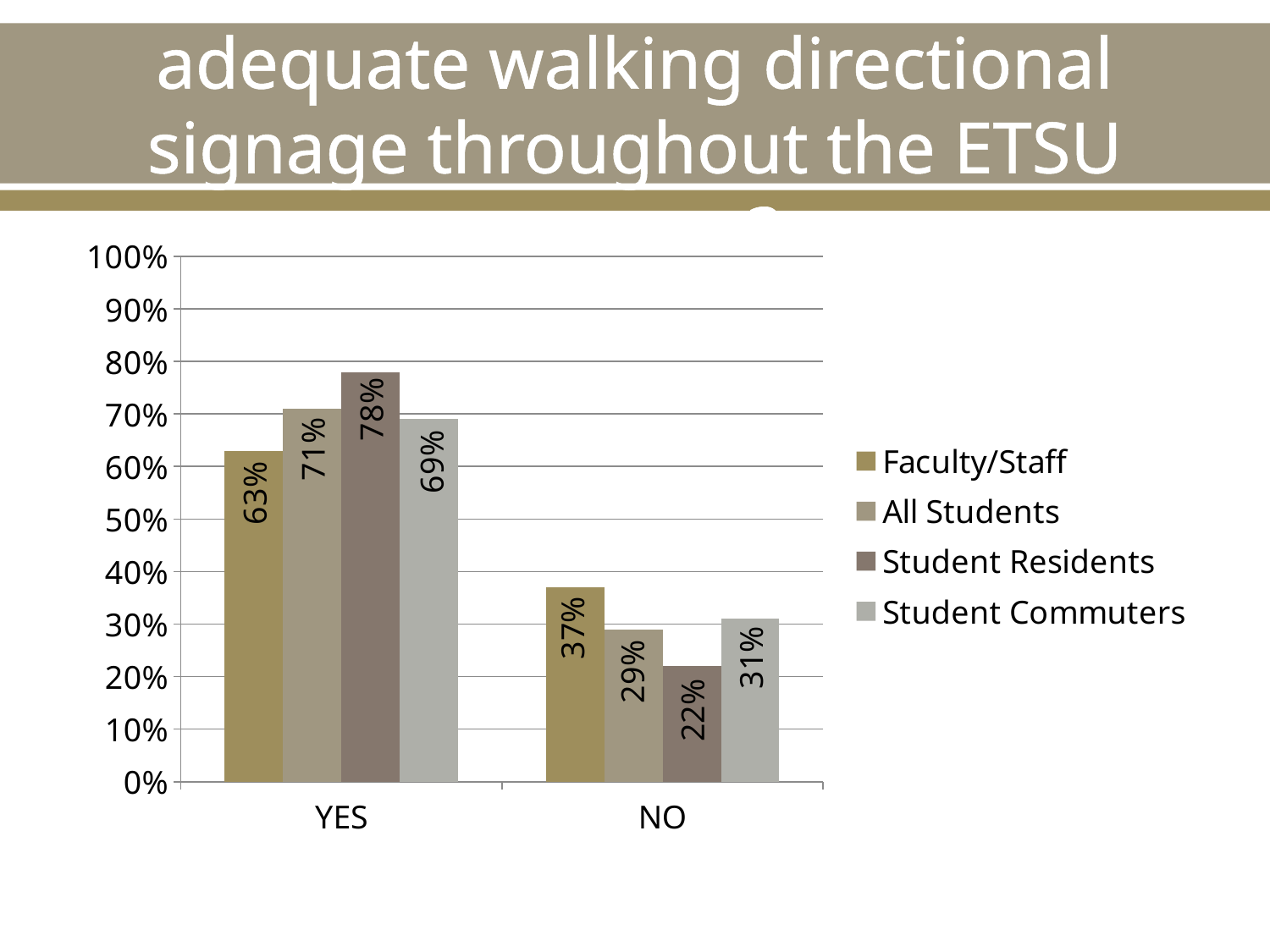
What is the value for Faculty/Staff in the YES category? 63% What kind of chart is shown on the slide? Bar chart How many categories are shown on the x axis? 2 How many series does the legend list? 4 What is the value for Student Residents in the NO category? 22% Which is larger in the NO category: Faculty/Staff or Student Commuters? Faculty/Staff What is the value for All Students in the NO category? 29% Which series has the highest value in the YES category? Student Residents What is the value for Student Commuters in the YES category? 69% Which series has the lowest value in the NO category? Student Residents Which legend entry is shown in the darkest brown colour? Student Residents What is the difference between the Student Residents and Faculty/Staff values in the YES category? 15%